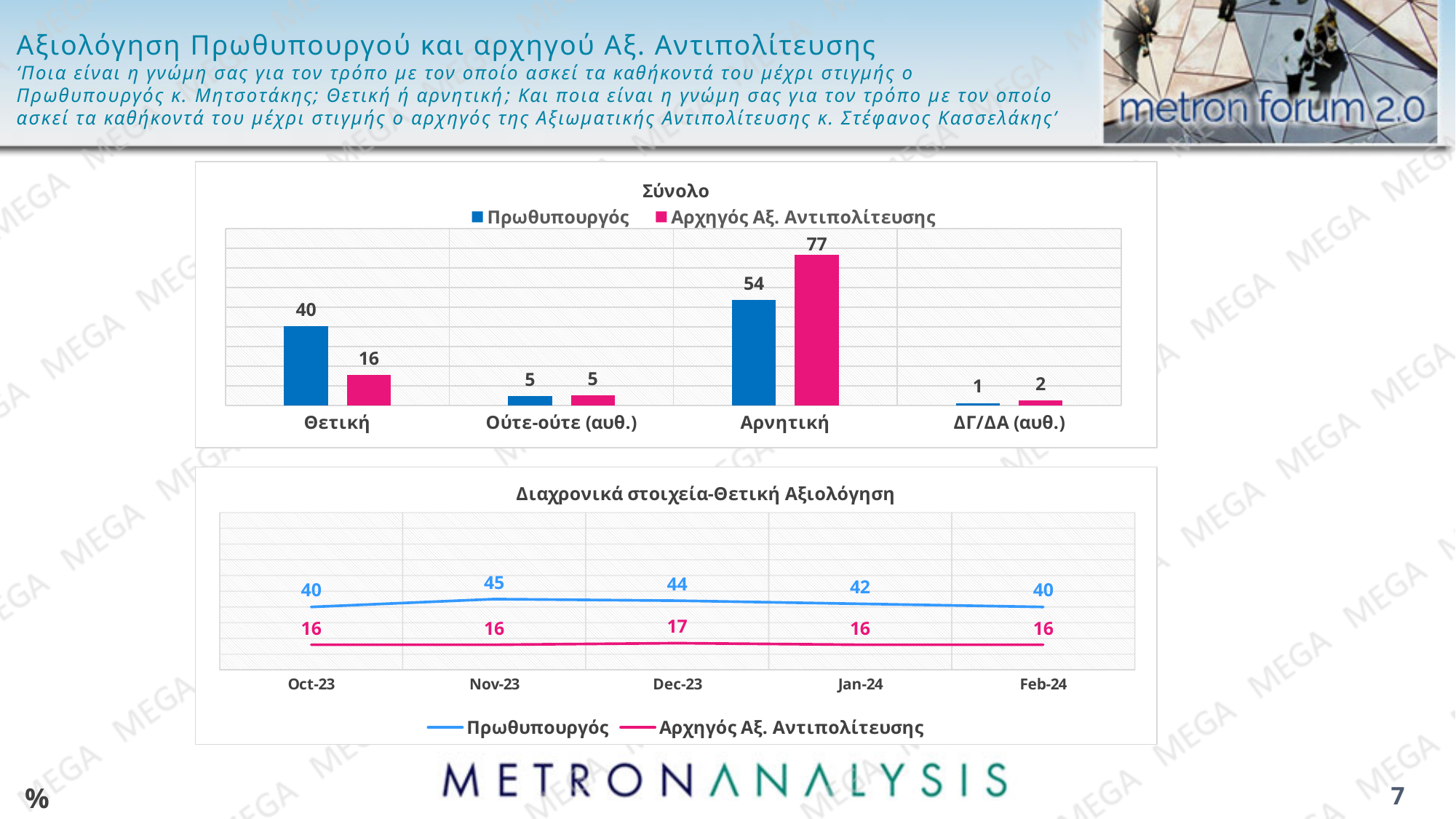
In the 'Σύνολο' chart, what is the value for Αρχηγός Αξ. Αντιπολίτευσης in the Αρνητική category? 77 In the 'Σύνολο' chart, what is the difference between the Αρνητική values for Αρχηγός Αξ. Αντιπολίτευσης and Πρωθυπουργός? 23 In the 'Σύνολο' chart, which series has the larger value in the Θετική category? Πρωθυπουργός In the 'Διαχρονικά στοιχεία-Θετική Αξιολόγηση' chart, does the Πρωθυπουργός line rise or fall from Nov-23 to Feb-24? Fall In the 'Σύνολο' chart, which category has the lowest value for Πρωθυπουργός? ΔΓ/ΔΑ (αυθ.) How many categories are shown on the x axis of the 'Σύνολο' chart? 4 What kind of chart is the 'Σύνολο' chart? Bar chart In the 'Σύνολο' chart, what is the value for Πρωθυπουργός in the Θετική category? 40 How many series does the legend of the 'Διαχρονικά στοιχεία-Θετική Αξιολόγηση' chart list? 2 In the 'Διαχρονικά στοιχεία-Θετική Αξιολόγηση' chart, what is the value for Αρχηγός Αξ. Αντιπολίτευσης in Dec-23? 17 In the 'Διαχρονικά στοιχεία-Θετική Αξιολόγηση' chart, what is the value for Πρωθυπουργός in Nov-23? 45 In the 'Σύνολο' chart, which category has the highest value for Αρχηγός Αξ. Αντιπολίτευσης? Αρνητική